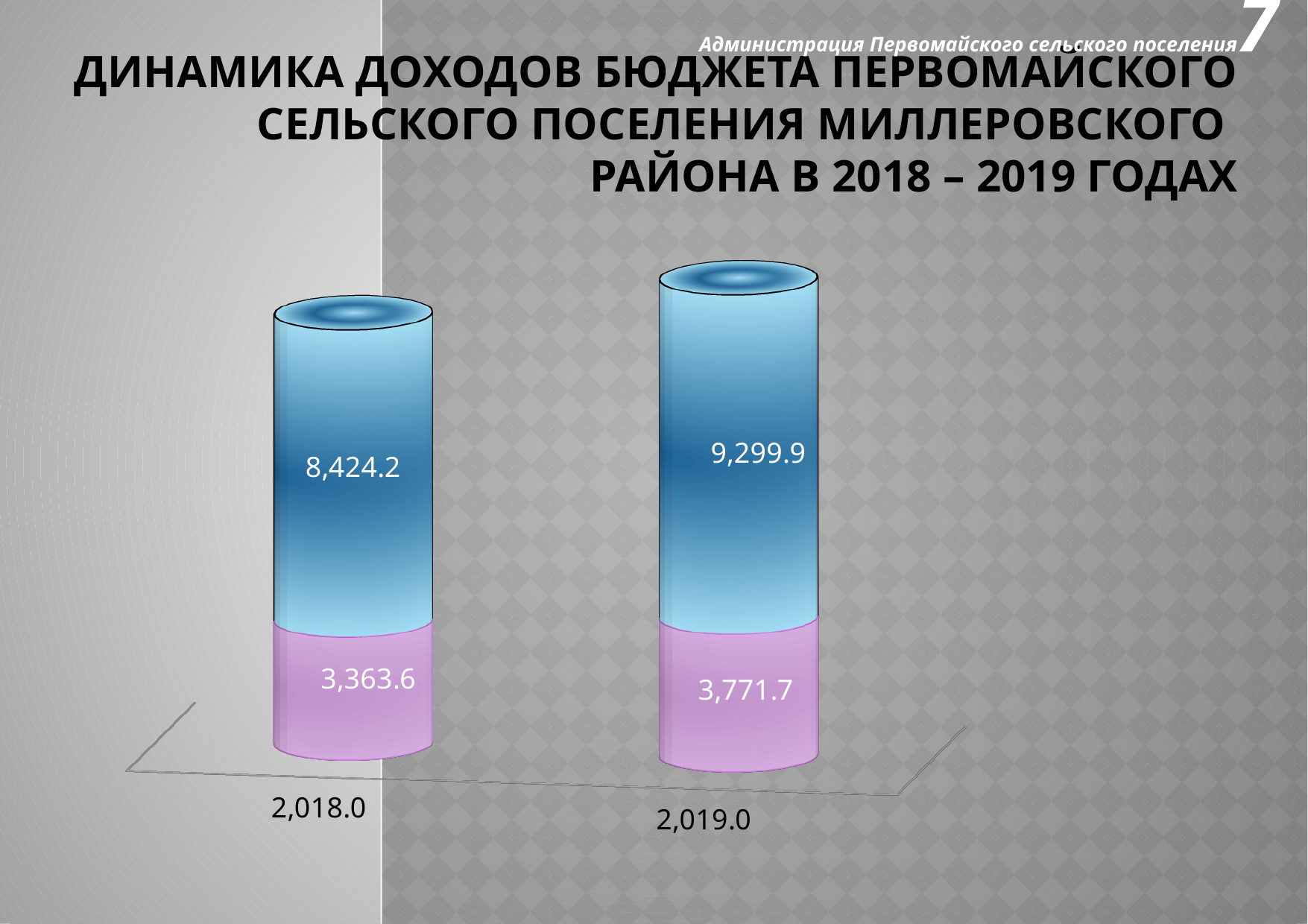
How many bars (categories) are shown in the chart? 2 By how much does the blue segment for 2,019.0 exceed the blue segment for 2,018.0? 875.7 What is the value of the blue segment for the 2,018.0 bar? 8,424.2 Which bar has the larger blue segment, 2,018.0 or 2,019.0? 2,019.0 What is the total of the stacked bar for 2,019.0? 13,071.6 What is the difference between the pink segments for 2,019.0 and 2,018.0? 408.1 What is the value of the pink segment for the 2,018.0 bar? 3,363.6 What is the value of the blue segment for the 2,019.0 bar? 9,299.9 What kind of chart is shown on the slide? Stacked bar chart Do the total bar values rise or fall from 2,018.0 to 2,019.0? Rise What is the value of the pink segment for the 2,019.0 bar? 3,771.7 What is the total of the stacked bar for 2,018.0? 11,787.8